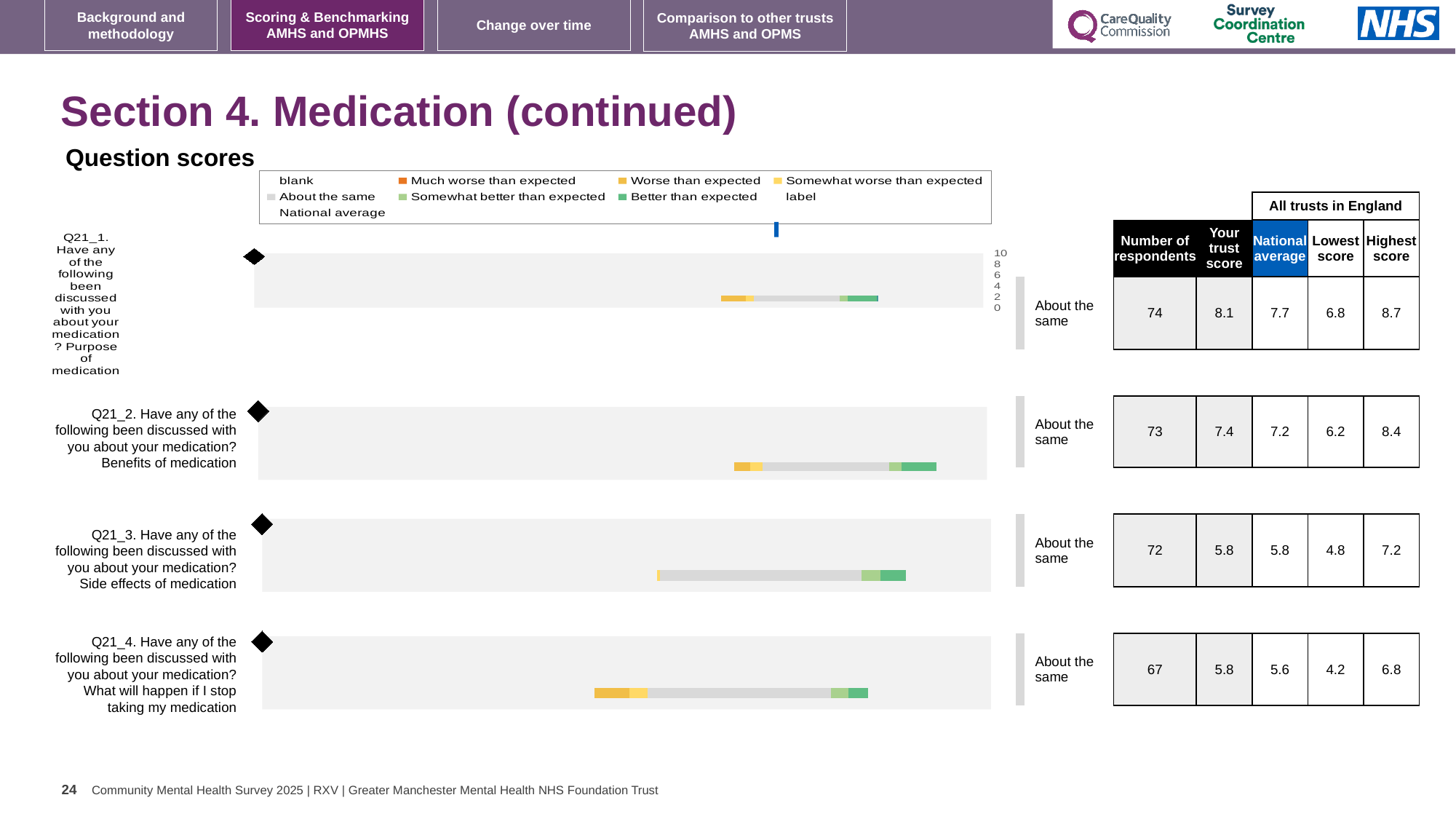
Which question has the lowest national average? Q21_4 (What will happen if I stop taking my medication) What benchmark category is shown next to the chart for Q21_3 (Side effects of medication)? About the same What kind of chart is used to show the question scores? Bar chart How many question charts are shown on the slide? 4 What is the 'Your trust score' for Q21_1 (Purpose of medication)? 8.1 For Q21_2, which is larger: the trust's score or the national average? Your trust score (7.4) How many respondents are shown for Q21_3 (Side effects of medication)? 72 Which question has the highest 'Your trust score'? Q21_1 (Purpose of medication) What is the lowest score across all trusts in England for Q21_4 (What will happen if I stop taking my medication)? 4.2 For Q21_1, what is the difference between the highest score and the lowest score across all trusts in England? 1.9 What is the national average for Q21_2 (Benefits of medication)? 7.2 For Q21_4, how much higher is the trust's score than the national average? 0.2